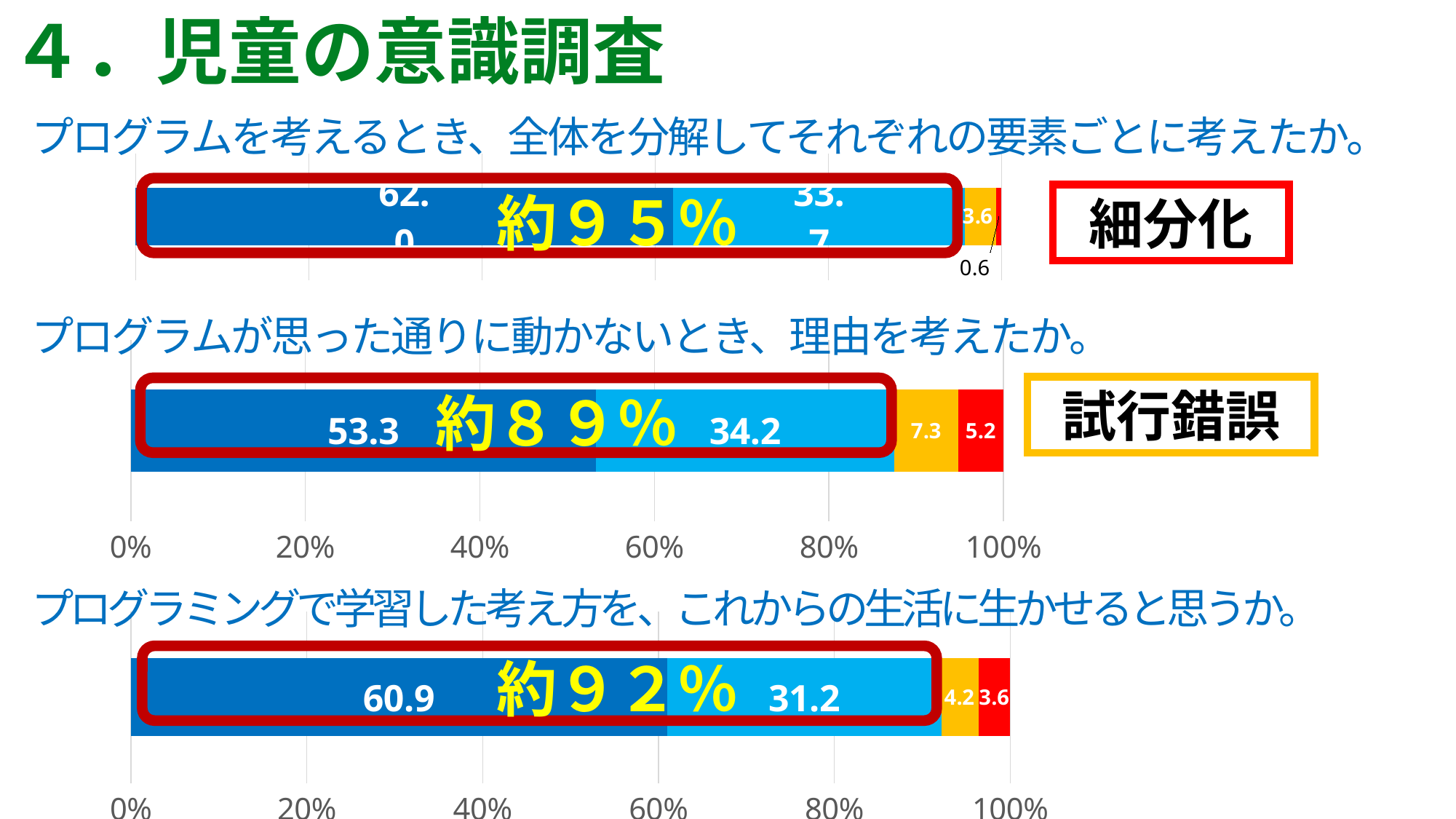
In the chart for 「プログラミングで学習した考え方を、これからの生活に生かせると思うか。」, what is the value of the dark blue segment? 60.9 In the chart for 「プログラムを考えるとき、全体を分解してそれぞれの要素ごとに考えたか。」, what is the value of the red segment? 0.6 How many segments does the bar in the chart for 「プログラムが思った通りに動かないとき、理由を考えたか。」 have? 4 In the chart for 「プログラミングで学習した考え方を、これからの生活に生かせると思うか。」, which segment has the smallest value? the red segment (3.6) In the chart for 「プログラミングで学習した考え方を、これからの生活に生かせると思うか。」, what is the combined value of the dark blue and light blue segments? 92.1 In the chart for 「プログラムが思った通りに動かないとき、理由を考えたか。」, what is the value of the light blue segment? 34.2 In the chart for 「プログラムが思った通りに動かないとき、理由を考えたか。」, what is the value of the dark blue segment? 53.3 What kind of chart is used for 「プログラムが思った通りに動かないとき、理由を考えたか。」? stacked bar chart In the chart for 「プログラムが思った通りに動かないとき、理由を考えたか。」, what is the value of the red segment? 5.2 In the chart for 「プログラムが思った通りに動かないとき、理由を考えたか。」, what is the difference between the dark blue and light blue segments? 19.1 In the chart for 「プログラミングで学習した考え方を、これからの生活に生かせると思うか。」, what is the value of the yellow segment? 4.2 In the chart for 「プログラムが思った通りに動かないとき、理由を考えたか。」, which segment has the largest value? the dark blue segment (53.3)